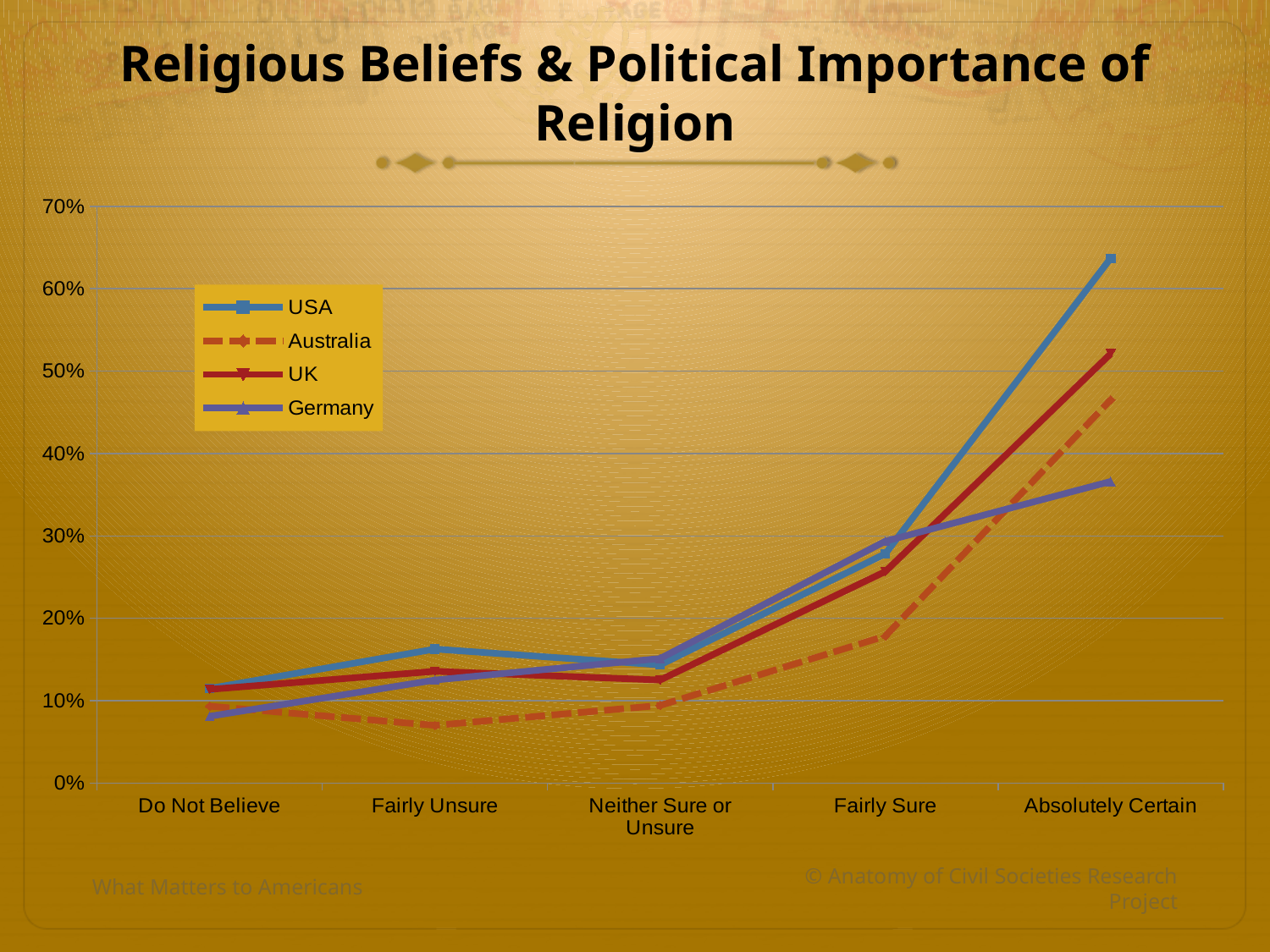
At Absolutely Certain, which is larger: the value for UK or the value for Australia? UK Which series has the lowest value at Absolutely Certain? Germany How many categories are shown along the x axis? 5 How many series does the legend list? 4 Does the Australia line rise or fall from Fairly Sure to Absolutely Certain? rise What kind of chart is shown on the slide? line chart What is the title of the chart? Religious Beliefs & Political Importance of Religion Is the value for USA at Absolutely Certain greater or less than 60%? greater Is the value for Germany at Absolutely Certain greater or less than 40%? less Is the value for Australia at Fairly Unsure greater or less than 10%? less Which series has the highest value at Absolutely Certain? USA Which series has the lowest value at Fairly Unsure? Australia